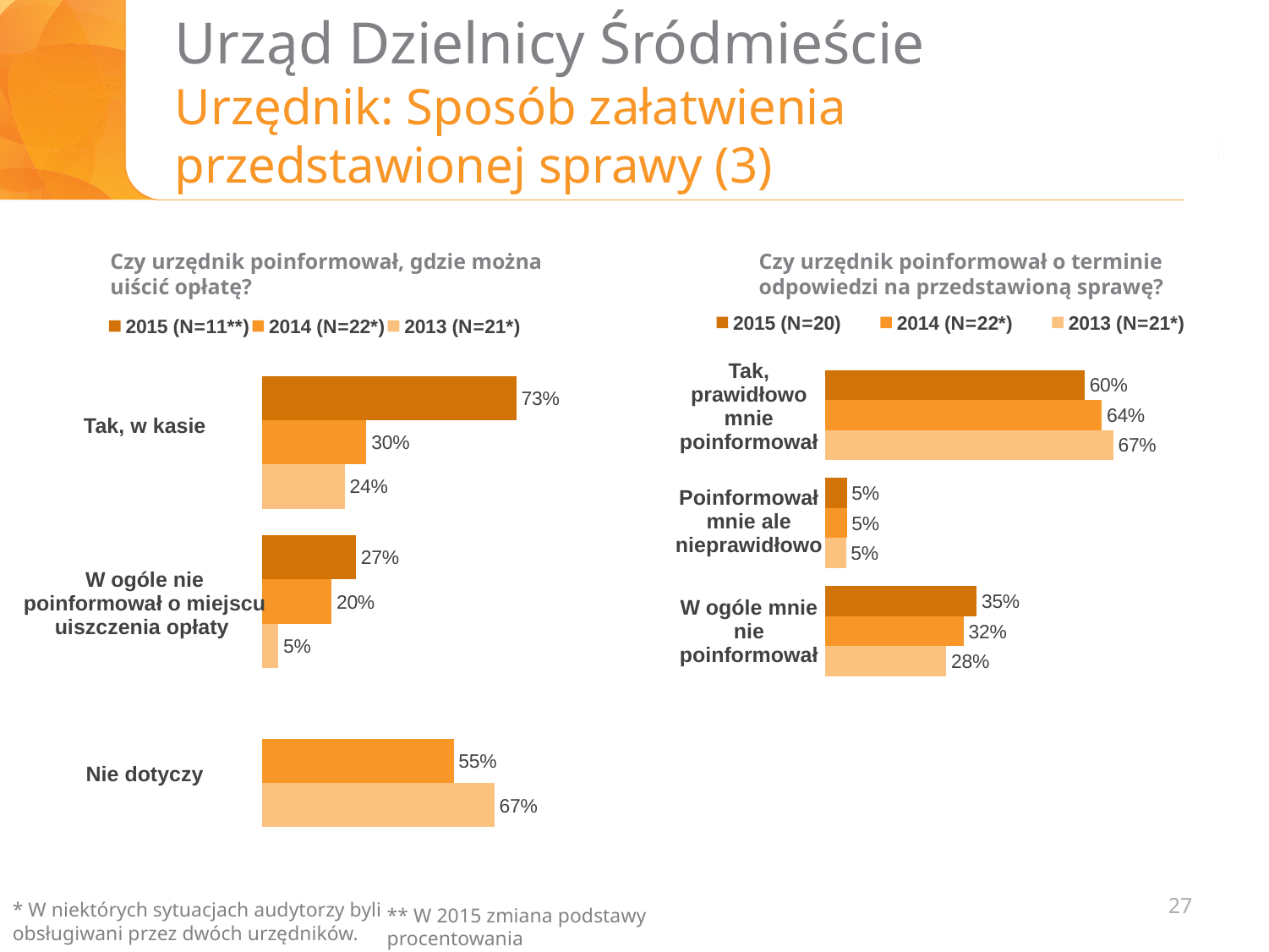
In the right chart ("Czy urzędnik poinformował o terminie odpowiedzi na przedstawioną sprawę?"), what is the 2015 value for "W ogóle mnie nie poinformował"? 35% What type of chart is used on the right side of the slide? Bar chart In the right chart ("Czy urzędnik poinformował o terminie odpowiedzi na przedstawioną sprawę?"), what is the difference between the 2013 and 2015 values for "Tak, prawidłowo mnie poinformował"? 7 percentage points In the left chart ("Czy urzędnik poinformował, gdzie można uiścić opłatę?"), how many categories are shown? 3 In the left chart ("Czy urzędnik poinformował, gdzie można uiścić opłatę?"), what is the 2013 value for "Nie dotyczy"? 67% In the right chart ("Czy urzędnik poinformował o terminie odpowiedzi na przedstawioną sprawę?"), what is the 2013 value for "Tak, prawidłowo mnie poinformował"? 67% In the left chart ("Czy urzędnik poinformował, gdzie można uiścić opłatę?"), what is the 2014 value for "W ogóle nie poinformował o miejscu uiszczenia opłaty"? 20% In the left chart ("Czy urzędnik poinformował, gdzie można uiścić opłatę?"), what is the value for "Tak, w kasie" in the 2015 series? 73% In the right chart ("Czy urzędnik poinformował o terminie odpowiedzi na przedstawioną sprawę?"), which category has the lowest values across all three years? Poinformował mnie ale nieprawidłowo In the right chart ("Czy urzędnik poinformował o terminie odpowiedzi na przedstawioną sprawę?"), which is larger for "W ogóle mnie nie poinformował": the 2014 value or the 2013 value? 2014 (32%) In the left chart ("Czy urzędnik poinformował, gdzie można uiścić opłatę?"), how many series does the legend list? 3 In the left chart ("Czy urzędnik poinformował, gdzie można uiścić opłatę?"), what is the difference between the 2015 and 2014 values for "Tak, w kasie"? 43 percentage points